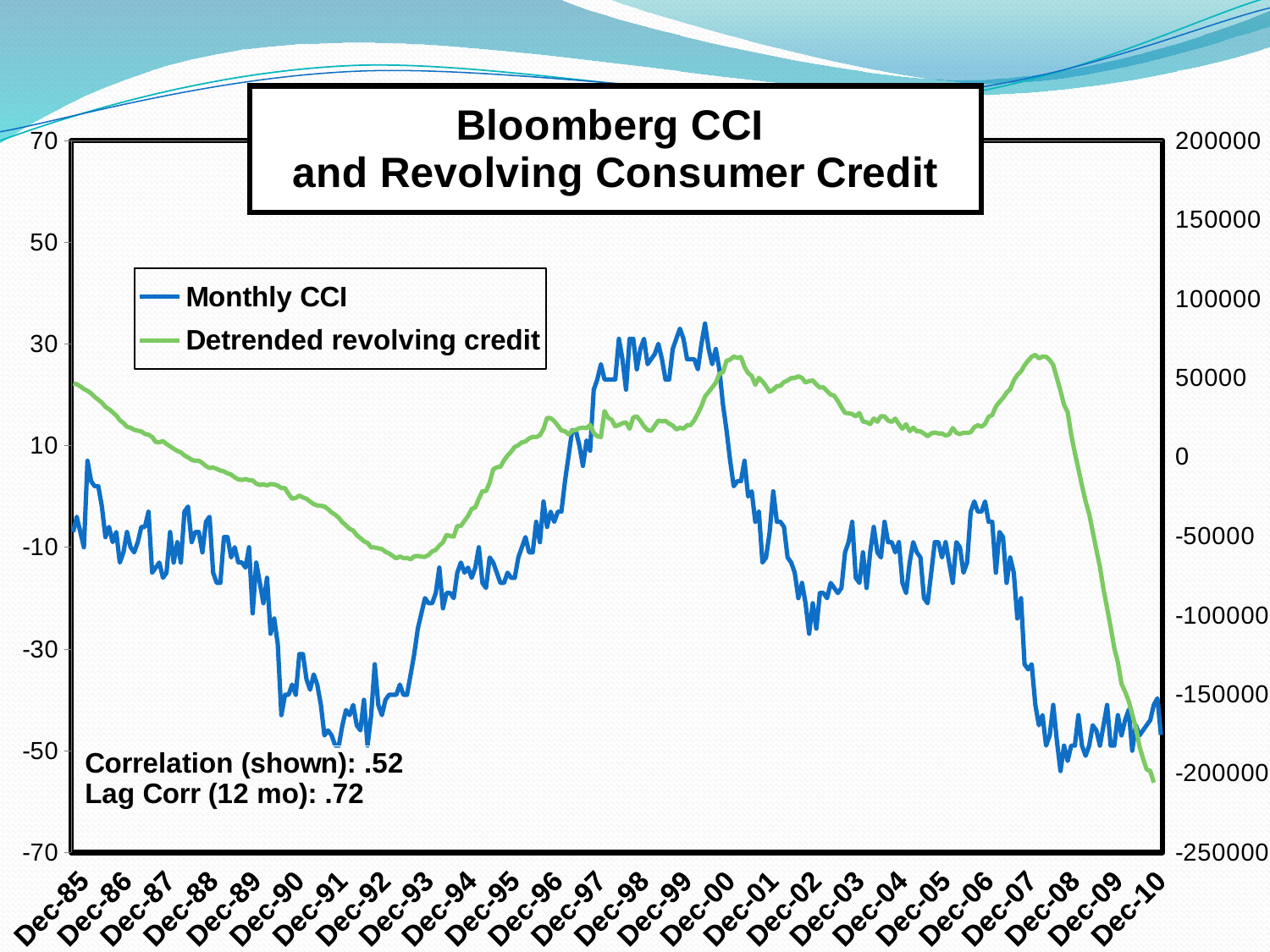
Does the Detrended revolving credit series rise or fall between Dec-07 and Dec-10? fall What is the title of the chart? Bloomberg CCI and Revolving Consumer Credit Is the Detrended revolving credit value at Dec-07 greater or less than 0? greater What correlation value is shown in the text on the chart? .52 What kind of chart is shown on the slide? line chart Does the Monthly CCI series rise or fall between Dec-91 and Dec-99? rise Is the Monthly CCI value at Dec-98 greater or less than 10? greater Is the Monthly CCI value higher at Dec-99 or at Dec-09? Dec-99 How many date labels are shown on the x axis? 26 Is the Monthly CCI value at Dec-91 greater or less than -30? less How many series does the legend list? 2